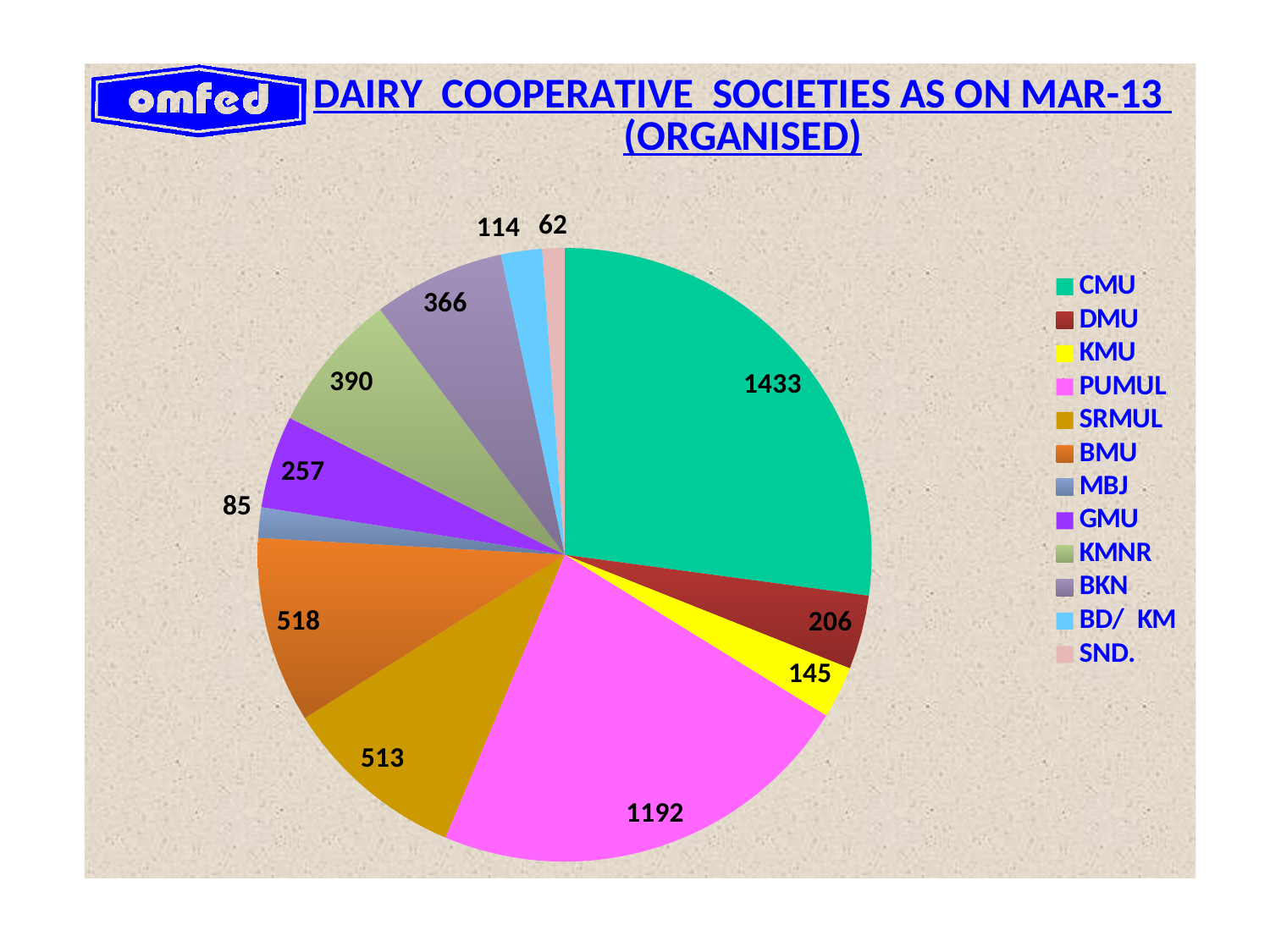
What is the difference between the values for BKN and BD/ KM? 252 Which category has the smallest slice? SND. What type of chart is shown on the slide? Pie chart What is the value for KMNR? 390 What is the value for PUMUL? 1192 How many categories does the pie chart show? 12 What is the title of the chart? DAIRY COOPERATIVE SOCIETIES AS ON MAR-13 (ORGANISED) Which is larger, the value for GMU or the value for DMU? GMU What is the difference between the values for CMU and PUMUL? 241 What is the value for BMU? 518 What is the total of all the slices in the pie chart? 5281 Which category has the largest slice? CMU